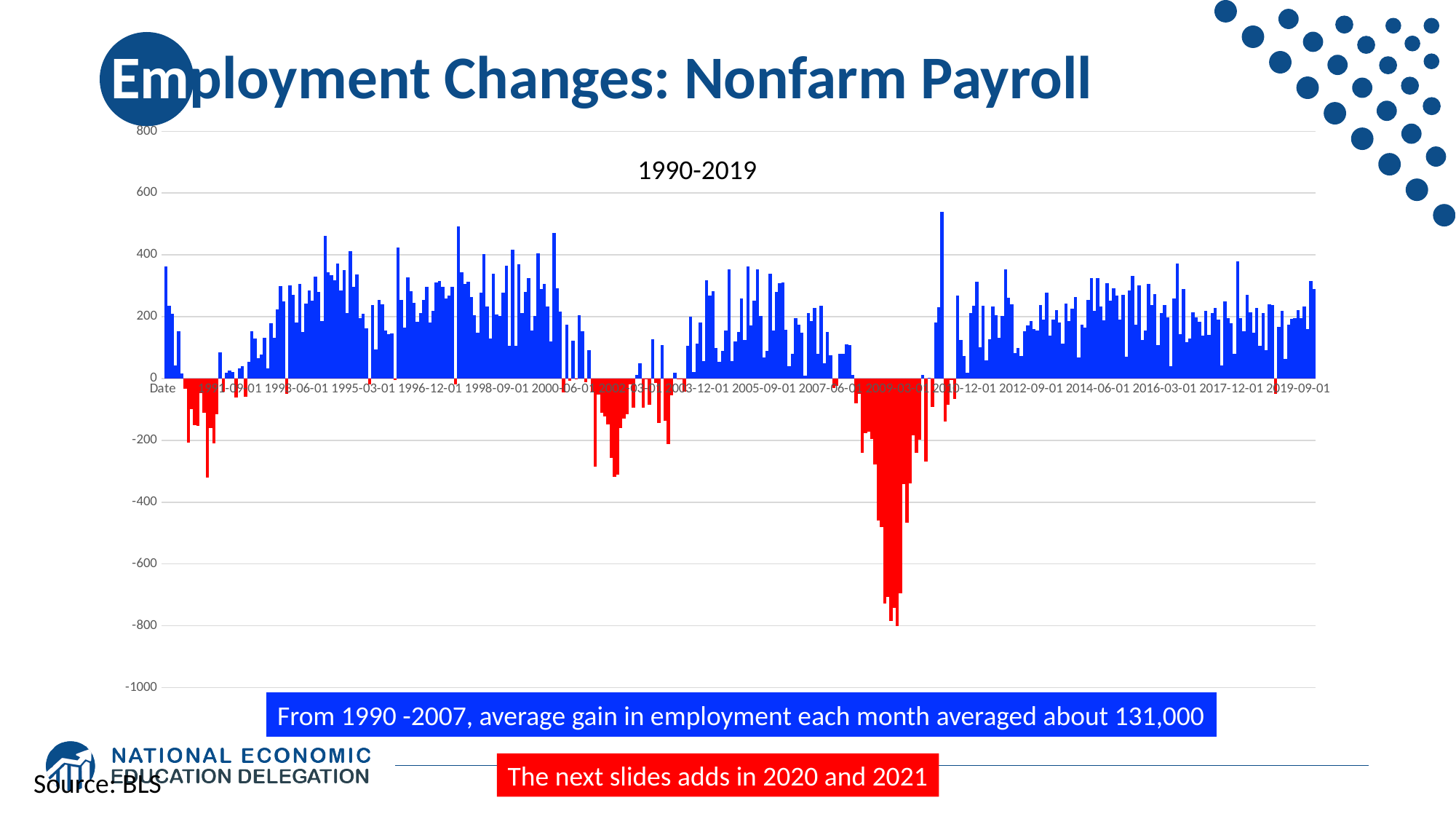
According to the slide, what was the average monthly gain in employment from 1990-2007? About 131,000 What colour are the bars representing negative employment changes? Red Is the bar at the far left of the chart (start of 1990) greater or less than 200? greater Is the tallest bar in the chart (shortly before 2010-12-01) greater or less than 400? greater What date range does the chart cover, according to the label above the bars? 1990-2019 What is the highest value shown on the vertical axis? 800 What is the title of the chart on the slide? Employment Changes: Nonfarm Payroll Are the bars around 2002-03-01 mostly above or below zero? Below zero What kind of chart is shown on the slide? Bar chart Around which x-axis date label do the deepest negative bars occur? 2009-03-01 Is the lowest bar in the chart (around 2009-03-01) greater or less than -600? less What is the lowest value shown on the vertical axis? -1000